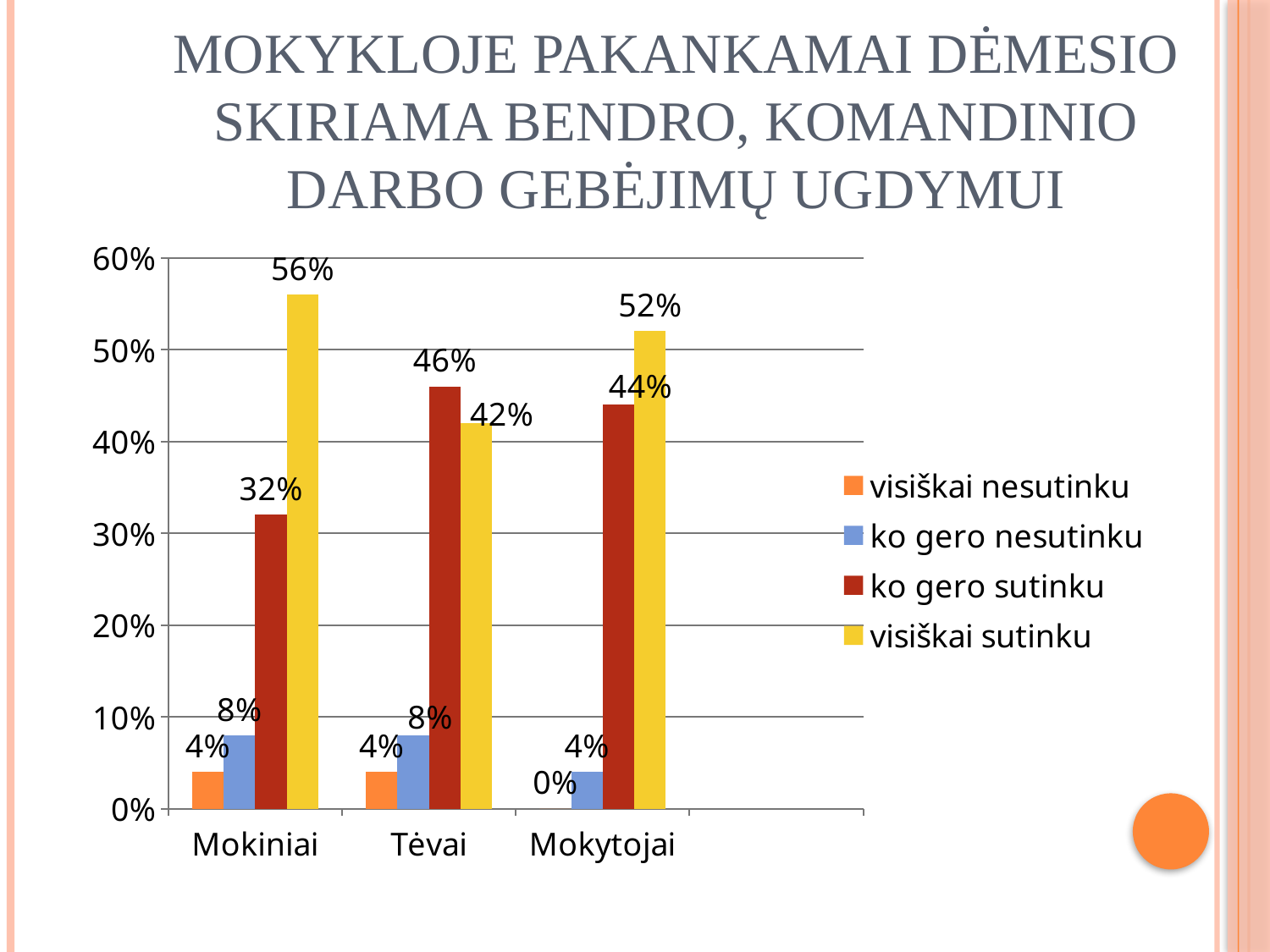
What kind of chart is shown on the slide? Bar chart How many series does the legend list? 4 What is the value for "ko gero sutinku" in the Tėvai category? 46% In the Tėvai category, which is larger: "ko gero sutinku" or "visiškai sutinku"? ko gero sutinku What is the value for "visiškai nesutinku" in the Mokytojai category? 0% Which colour represents the "visiškai sutinku" series? Yellow What is the value for "visiškai sutinku" in the Mokiniai category? 56% What is the difference between "visiškai sutinku" and "ko gero sutinku" in the Mokiniai category? 24% How many categories are shown on the x axis? 3 Which category has the lowest value for "ko gero sutinku"? Mokiniai What is the value for "ko gero nesutinku" in the Mokytojai category? 4% Which category has the highest value for "visiškai sutinku"? Mokiniai